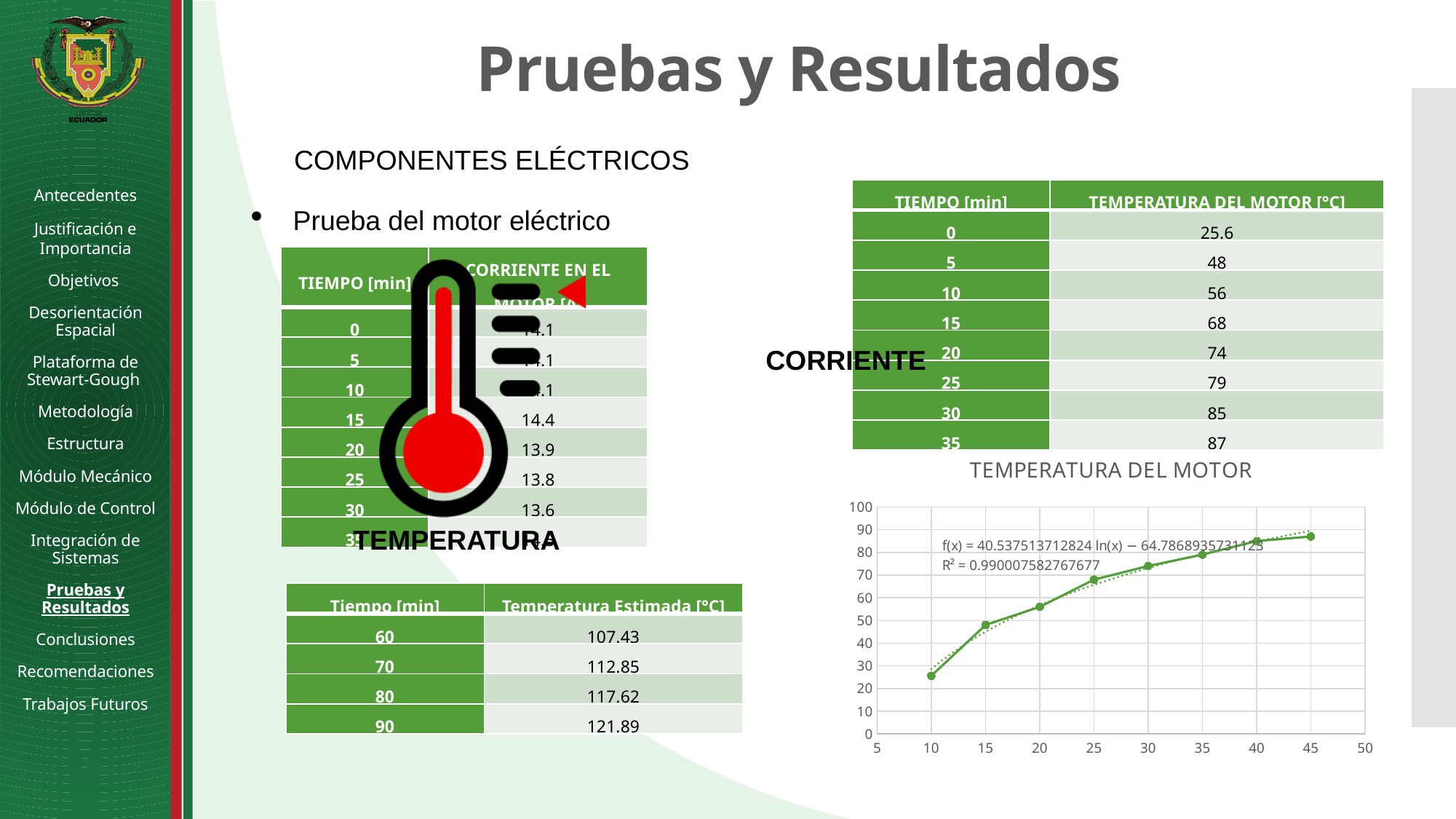
In the "TEMPERATURA DEL MOTOR" chart, at which x value is the plotted point lowest? 10 How many data points are plotted in the "TEMPERATURA DEL MOTOR" chart? 8 What is the title of the chart on the slide? TEMPERATURA DEL MOTOR In the "TEMPERATURA DEL MOTOR" chart, is the value of the point at x = 45 greater or less than 80? greater In the "TEMPERATURA DEL MOTOR" chart, is the value of the point at x = 35 greater or less than 70? greater In the "TEMPERATURA DEL MOTOR" chart, do the values rise or fall as you move along the x axis? rise In the "TEMPERATURA DEL MOTOR" chart, is the value of the point at x = 10 greater or less than 30? less What R² value is printed on the "TEMPERATURA DEL MOTOR" chart? 0.990007582767677 In the "TEMPERATURA DEL MOTOR" chart, which point is higher: the one at x = 10 or the one at x = 45? x = 45 In the "TEMPERATURA DEL MOTOR" chart, at which x value is the plotted point highest? 45 What kind of chart is the "TEMPERATURA DEL MOTOR" chart? line chart